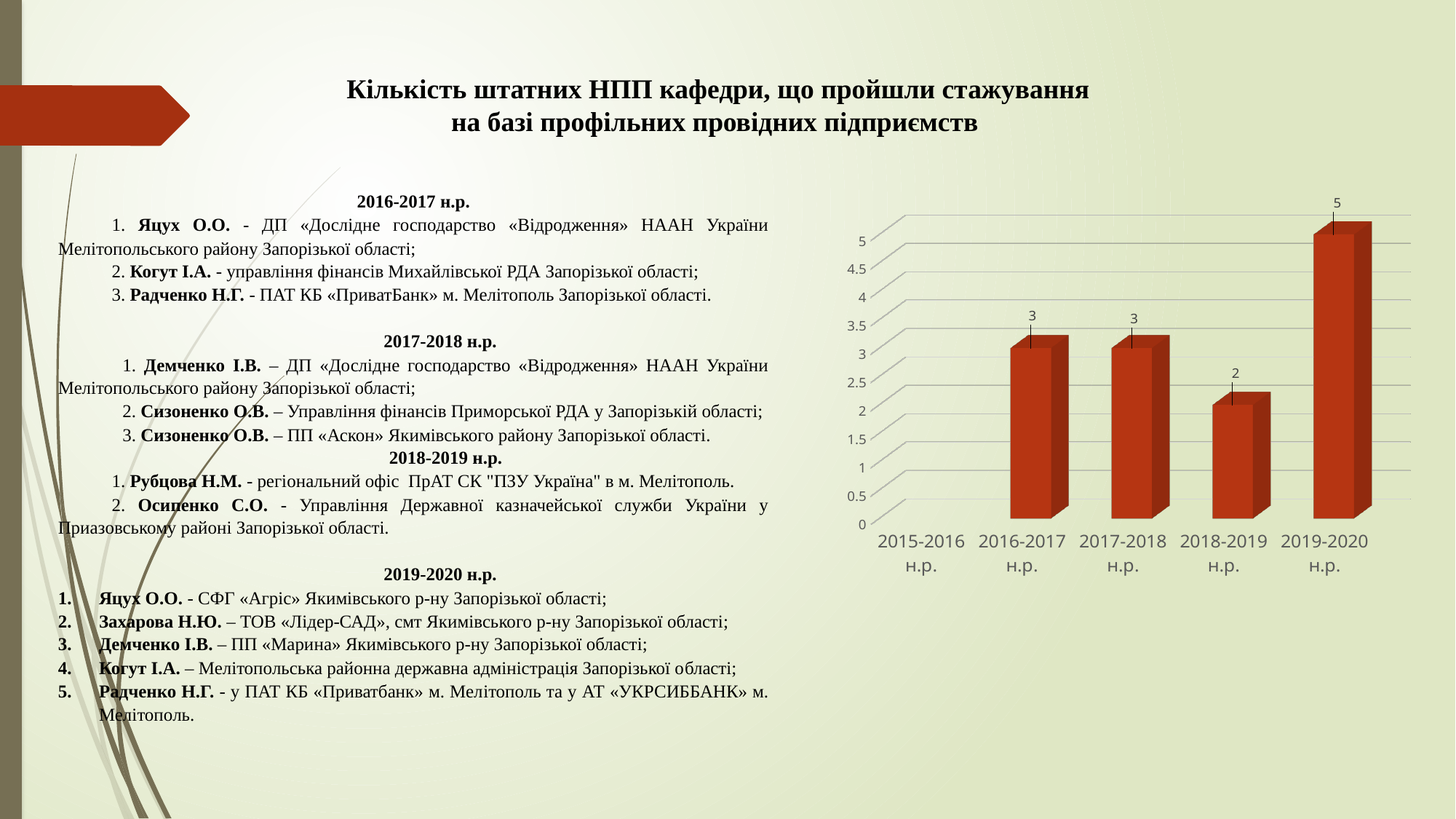
Among the years with a visible bar, which has the lowest value? 2018-2019 н.р. What is the maximum value shown on the vertical axis? 5 What type of chart is shown on the slide? bar chart Which academic year has the highest value? 2019-2020 н.р. What is the value for 2018-2019 н.р.? 2 How many academic-year categories are shown on the x axis? 5 What is the difference between the values for 2019-2020 н.р. and 2018-2019 н.р.? 3 Is the value for 2019-2020 н.р. greater or less than 4? greater What is the value for 2019-2020 н.р.? 5 What is the value for 2016-2017 н.р.? 3 What is the value for 2017-2018 н.р.? 3 Which is larger, the value for 2019-2020 н.р. or the value for 2016-2017 н.р.? 2019-2020 н.р.